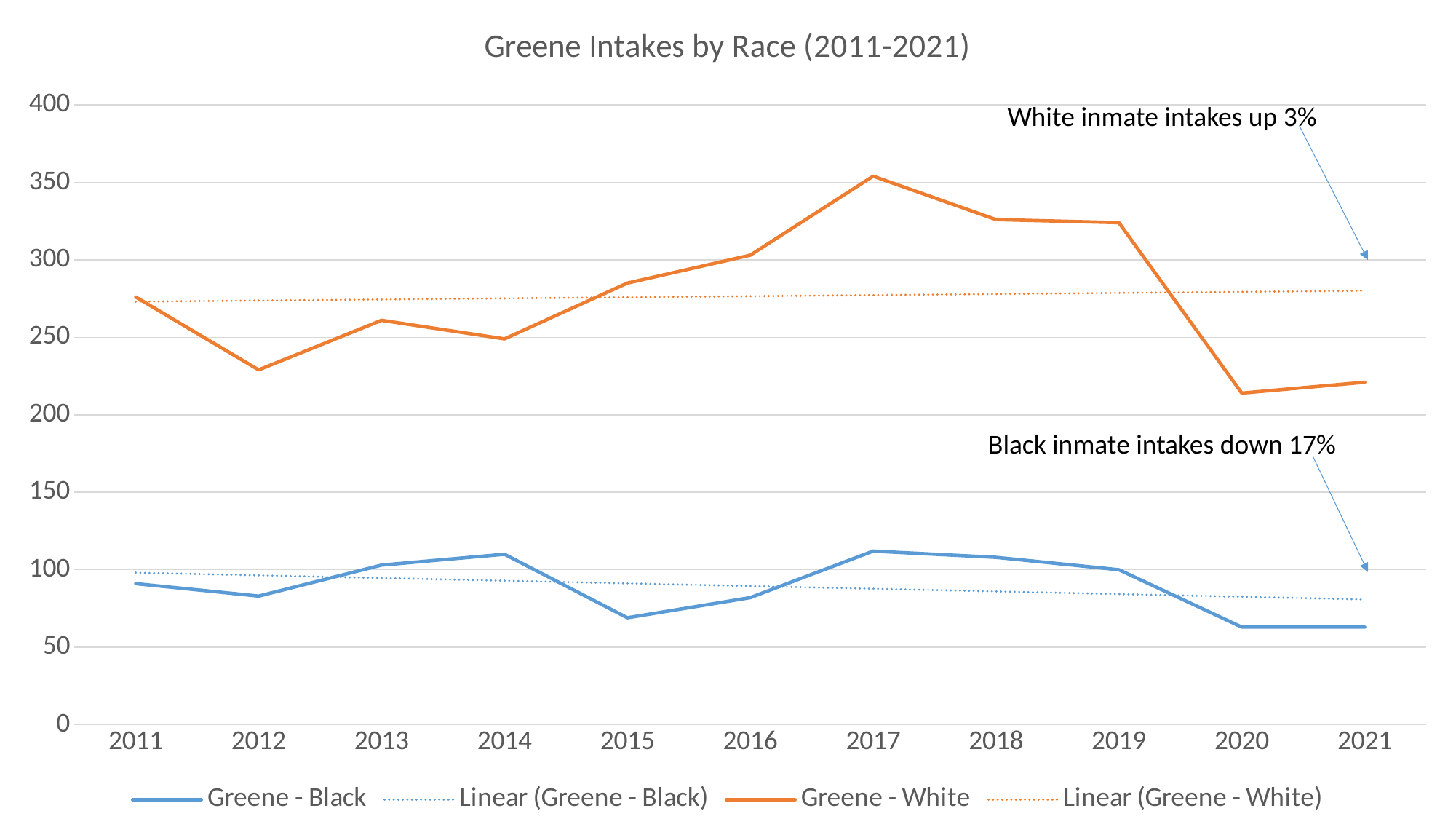
According to the annotation on the chart, by what percentage are Black inmate intakes down? 17% Is the Greene - Black value for 2014 greater or less than 100? greater Does the Greene - White series rise or fall from 2019 to 2020? fall What is the title of the chart? Greene Intakes by Race (2011-2021) Is the Greene - Black value for 2015 greater or less than 100? less In which year does the Greene - White series reach its highest value? 2017 How many years are plotted along the x axis? 11 Is the Greene - White value for 2012 greater or less than 250? less What type of chart is shown on the slide? line chart How many entries does the chart legend list? 4 Which is larger for the Greene - White series: the value in 2017 or the value in 2012? 2017